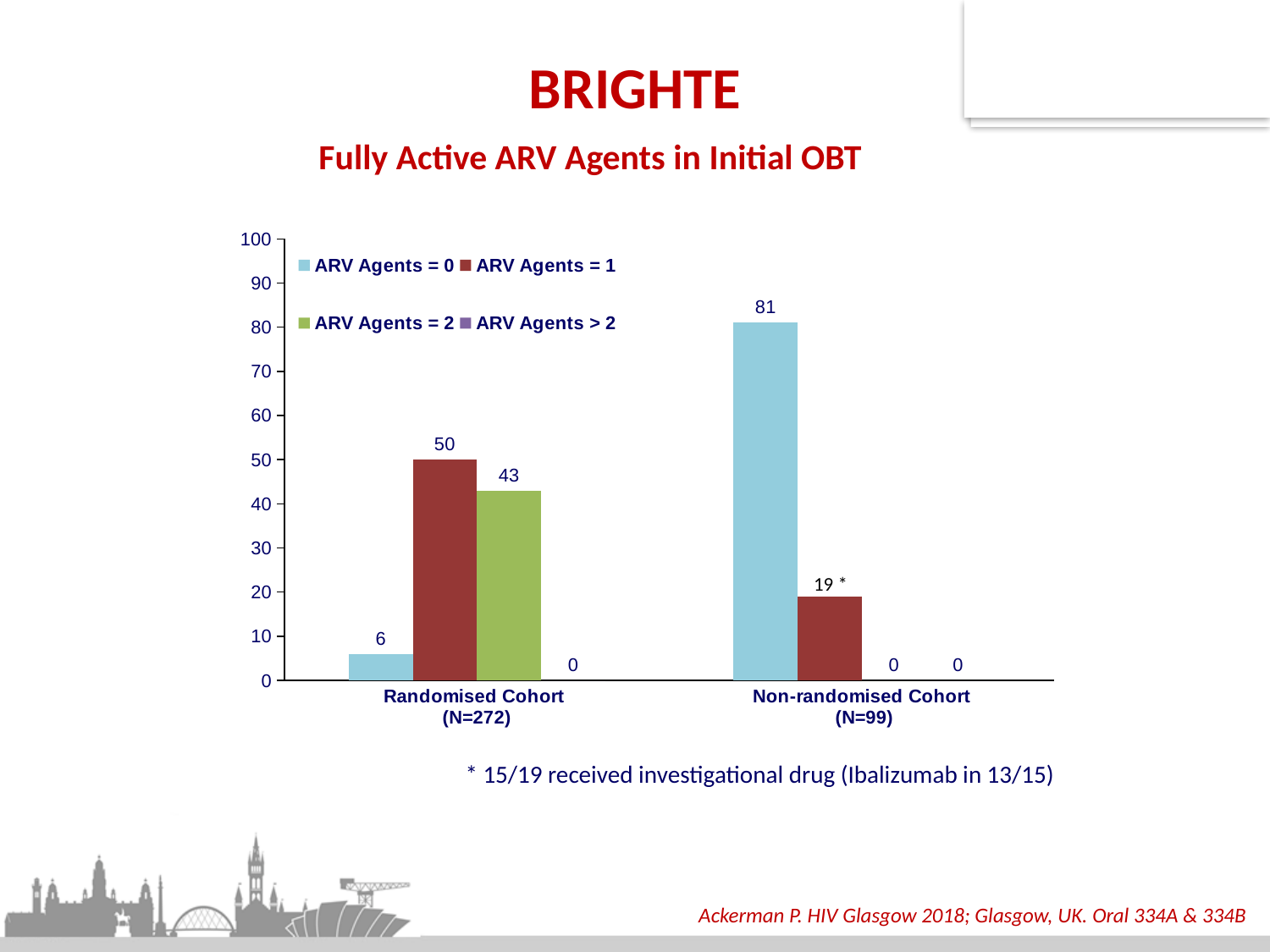
What kind of chart is shown on the slide? Bar chart Which series has the highest value in the Non-randomised Cohort (N=99)? ARV Agents = 0 Which is larger: ARV Agents = 0 in the Randomised Cohort or ARV Agents = 0 in the Non-randomised Cohort? Non-randomised Cohort What is the difference between the ARV Agents = 1 and ARV Agents = 2 values in the Randomised Cohort (N=272)? 7 What is the value for ARV Agents = 1 in the Non-randomised Cohort (N=99)? 19 What is the value for ARV Agents = 1 in the Randomised Cohort (N=272)? 50 Which series has the highest value in the Randomised Cohort (N=272)? ARV Agents = 1 What is the value for ARV Agents = 0 in the Randomised Cohort (N=272)? 6 How many cohort categories are shown on the x axis? 2 What is the value for ARV Agents = 2 in the Randomised Cohort (N=272)? 43 What is the value for ARV Agents = 0 in the Non-randomised Cohort (N=99)? 81 How many series does the legend list? 4